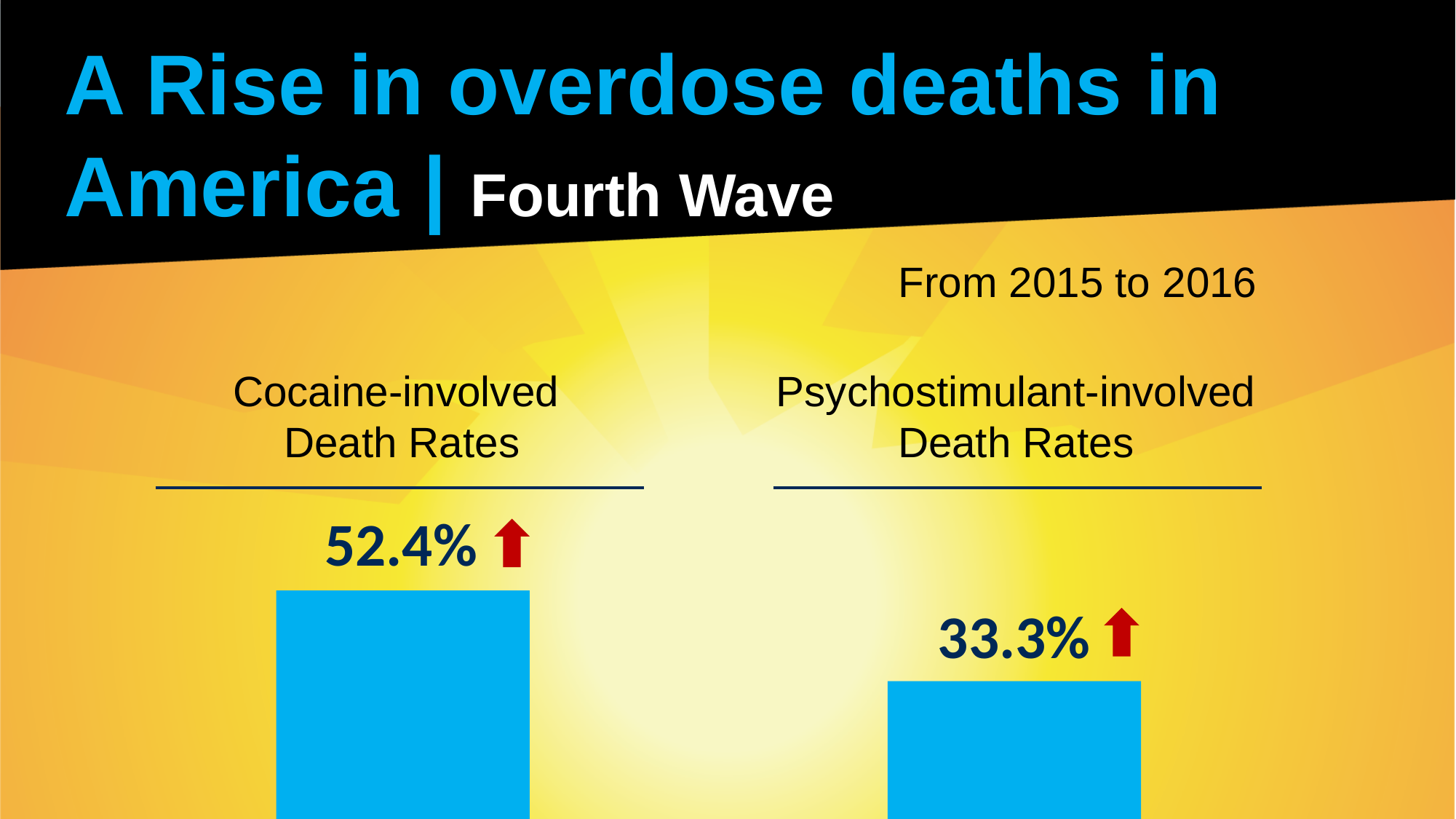
What kind of chart is shown on the slide? Bar chart How many categories are shown in the chart? 2 What is the difference between the Cocaine-involved and Psychostimulant-involved death rate increases? 19.1% What is the value shown for Cocaine-involved Death Rates? 52.4% What is the value shown for Psychostimulant-involved Death Rates? 33.3% Which category shows the largest increase? Cocaine-involved Death Rates Which category has the higher value, Cocaine-involved Death Rates or Psychostimulant-involved Death Rates? Cocaine-involved Death Rates What colour are the bars in the chart? Blue Which category shows the smallest increase? Psychostimulant-involved Death Rates What time period do the values on the chart cover? From 2015 to 2016